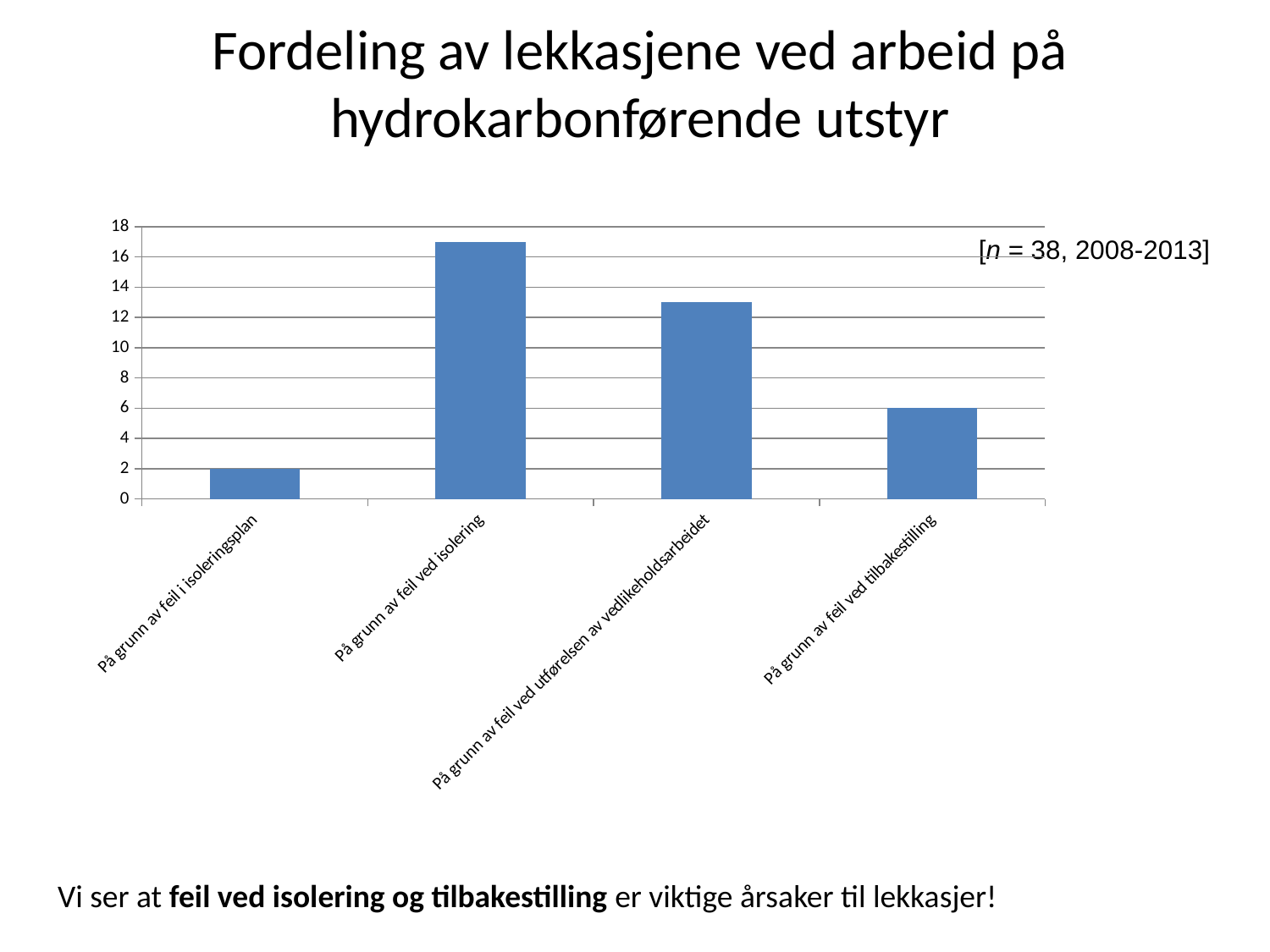
What kind of chart is shown on the slide? Bar chart Is the value for 'På grunn av feil ved utførelsen av vedlikeholdsarbeidet' greater or less than 14? less Which category has the lowest bar? På grunn av feil i isoleringsplan Which category has the highest bar? På grunn av feil ved isolering Is the value for 'På grunn av feil ved isolering' greater or less than 16? greater What is the difference between the values for 'På grunn av feil ved tilbakestilling' and 'På grunn av feil i isoleringsplan'? 4 What is the value for 'På grunn av feil i isoleringsplan'? 2 What is the highest value shown on the y axis of the chart? 18 What is the value for 'På grunn av feil ved tilbakestilling'? 6 What sample size and period are noted in the annotation on the chart? n = 38, 2008-2013 How many categories are shown on the x axis of the chart? 4 Which is larger: the value for 'På grunn av feil ved isolering' or for 'På grunn av feil ved utførelsen av vedlikeholdsarbeidet'? På grunn av feil ved isolering